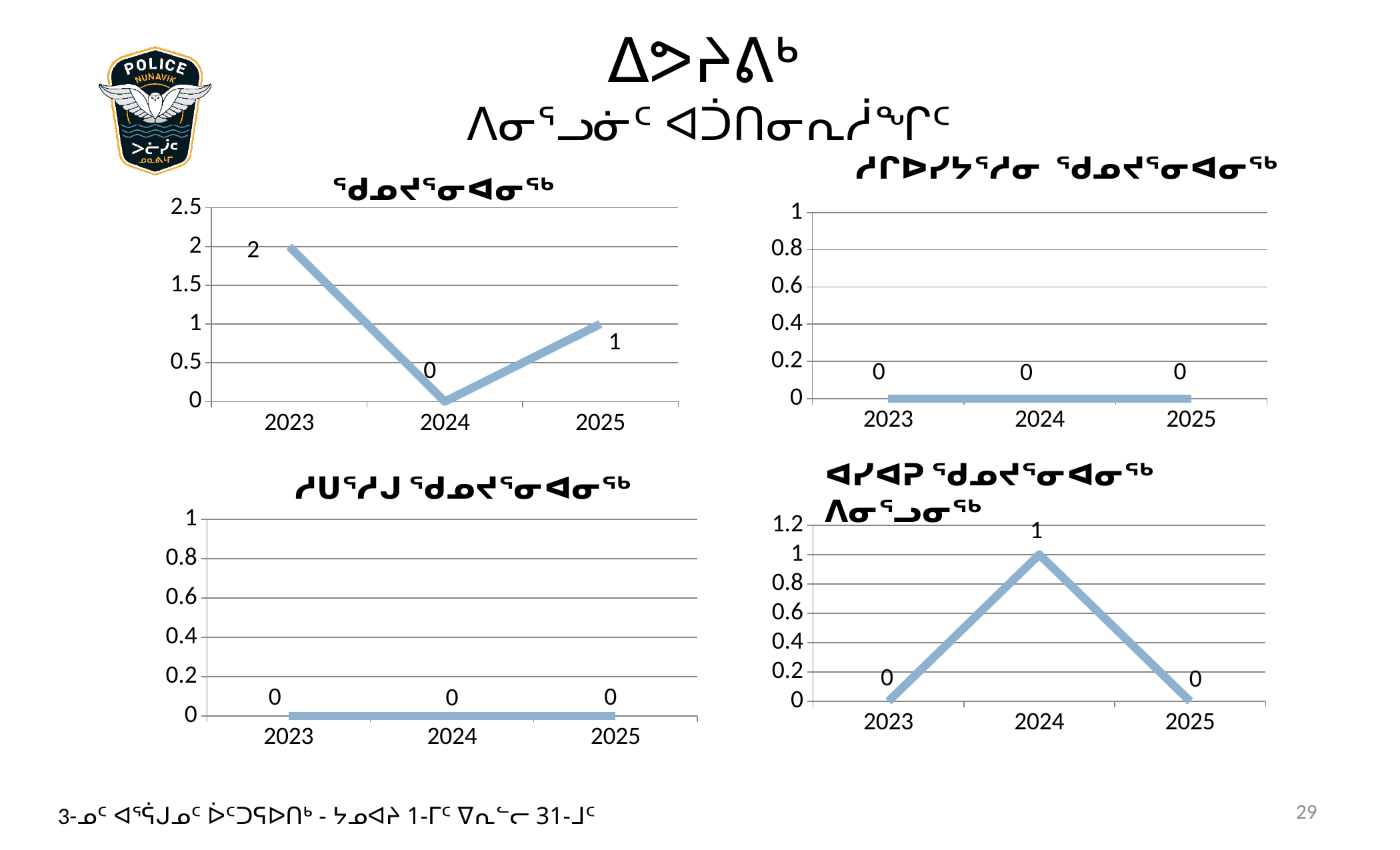
In the bottom-right chart, which year has the highest value? 2024 In the bottom-left chart, what is the value for 2023? 0 In the top-right chart, what is the value for 2025? 0 In the top-left chart, what is the value for 2023? 2 In the bottom-right chart, what is the value for 2024? 1 How many years are plotted on the x axis of the bottom-left chart? 3 In the top-left chart, what is the value for 2025? 1 In the top-left chart, what is the difference between the values for 2023 and 2025? 1 What kind of chart is the top-left chart? Line chart In the top-left chart, which year has the highest value? 2023 In the top-left chart, which year has the lowest value? 2024 In the top-left chart, is the value for 2023 larger or the value for 2025? 2023